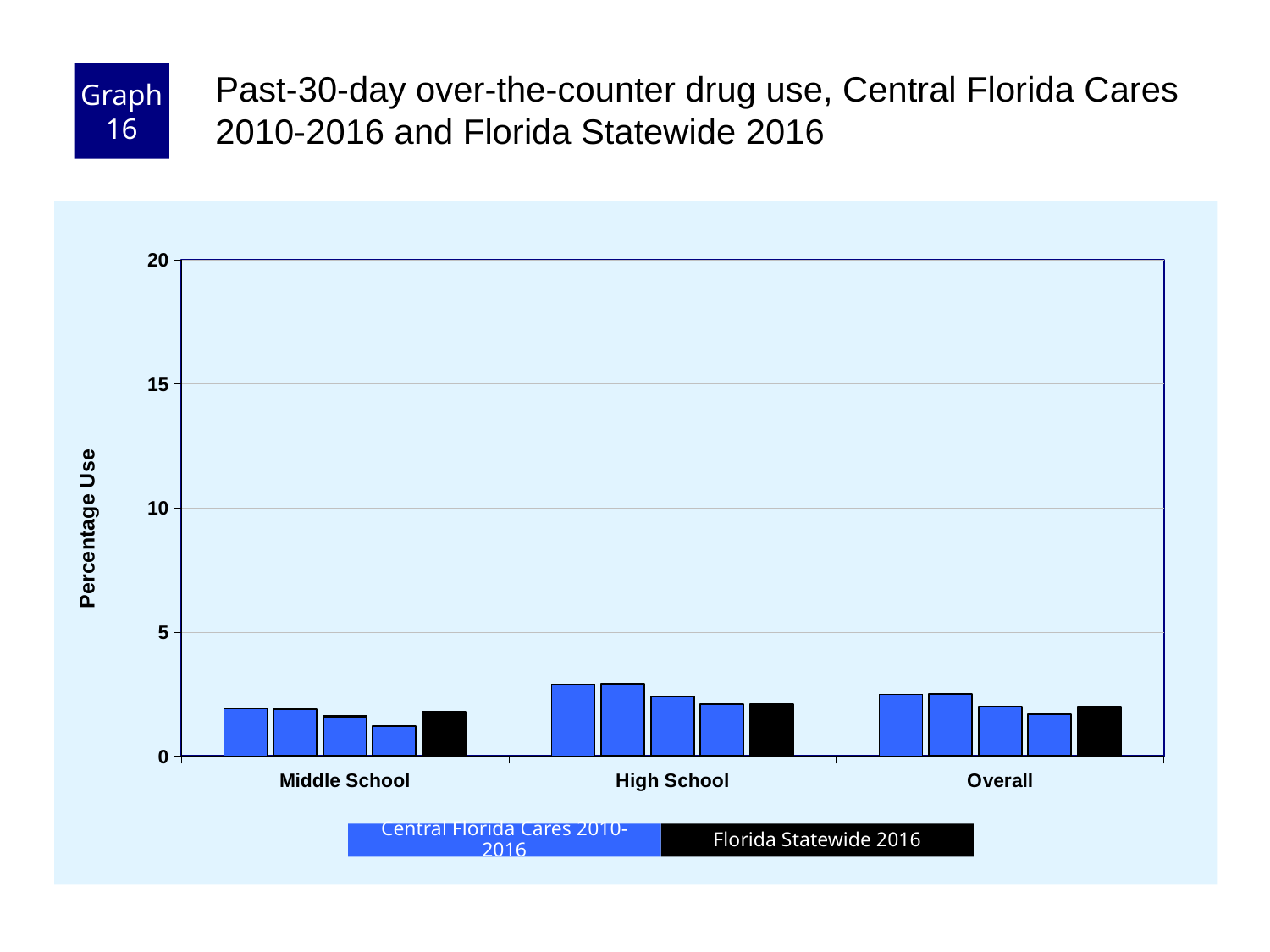
Are any of the Central Florida Cares 2010-2016 bars in the High School category greater or less than 5? less Is the value for Florida Statewide 2016 in the Middle School category greater or less than 5? less What kind of chart is shown on the slide? bar chart Which colour represents Florida Statewide 2016 in the chart's legend? black Is the value for Florida Statewide 2016 in the High School category greater or less than 5? less How many series does the chart's legend list? 2 How many categories are shown on the x axis of the chart? 3 What is the label on the vertical axis of the chart? Percentage Use